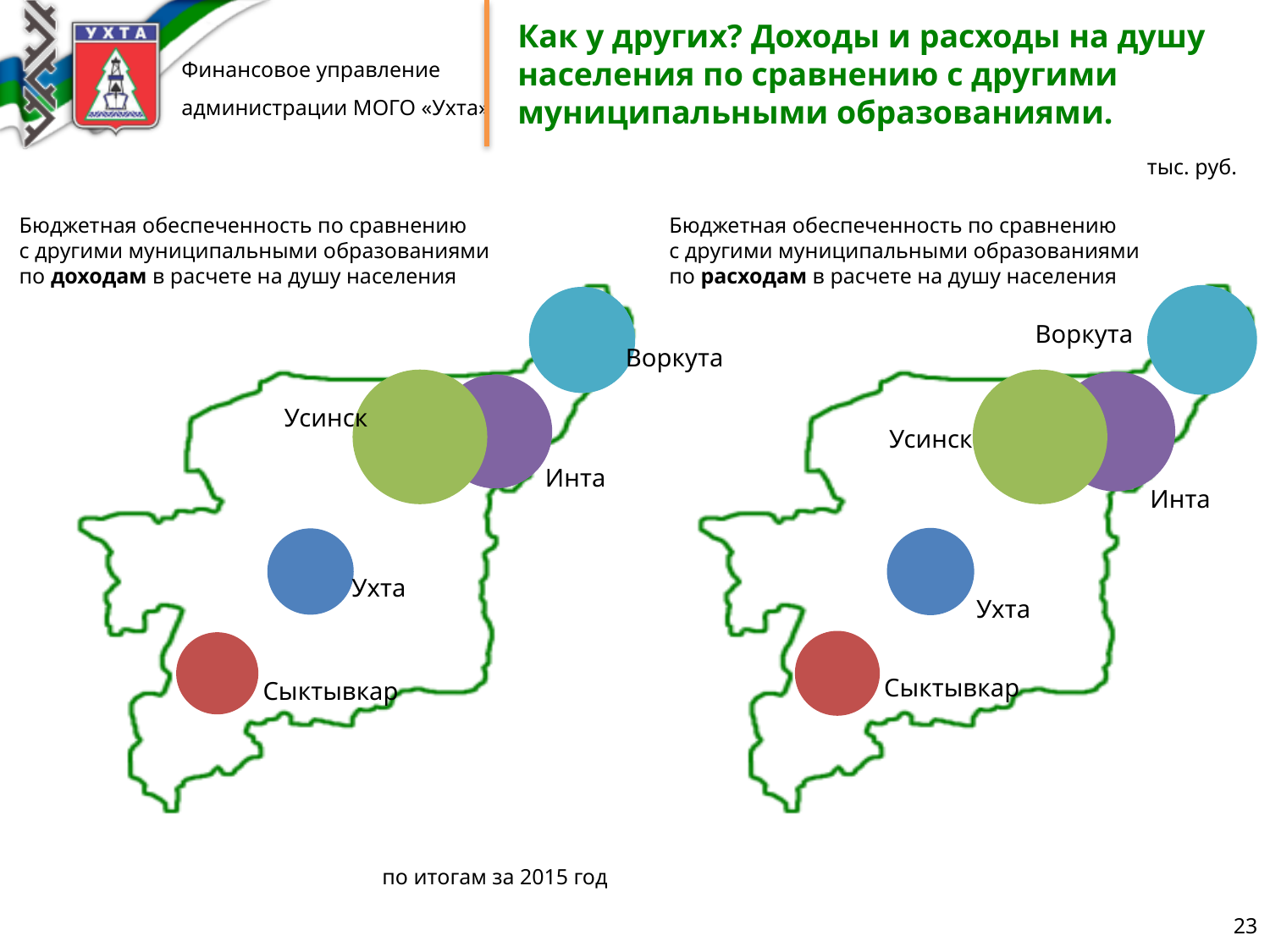
On the left chart (по доходам), which bubble is larger: Усинск or Ухта? Усинск On the left chart (по доходам), which municipality has the largest bubble? Усинск On the left chart (по доходам), which bubble is larger: Усинск or Инта? Усинск On the right chart (по расходам), which bubble is larger: Инта or Сыктывкар? Инта What colour is the bubble for Ухта on the left chart (по доходам)? Blue On the right chart (по расходам), how many municipalities are shown as bubbles? 5 On the right chart (по расходам), which municipality has the largest bubble? Усинск What unit is stated for the values on the slide? тыс. руб. What kind of chart is used on the left (по доходам) to compare municipalities? Bubble chart On the left chart (по доходам), how many municipalities are shown as bubbles? 5